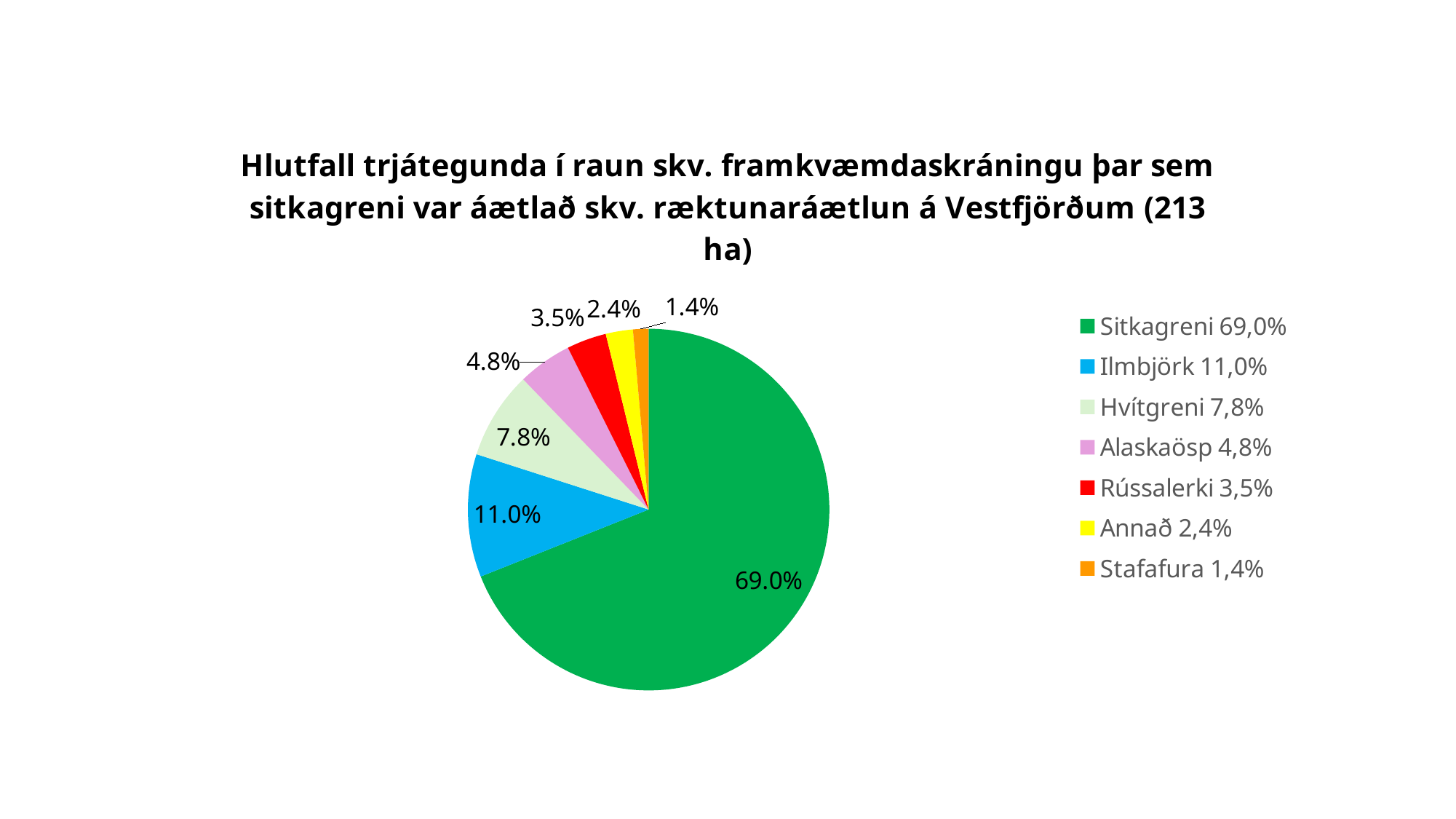
What colour is the slice for Ilmbjörk? blue How many slices does the pie chart have? 7 What is the value shown for Alaskaösp? 4.8% Which is larger, the share for Rússalerki or the share for Annað? Rússalerki What is the difference between the shares of Ilmbjörk and Hvítgreni? 3.2% What is the value shown for Stafafura? 1.4% Which tree species has the largest slice of the pie? Sitkagreni What is the value shown for Ilmbjörk? 11.0% What share of the pie does Sitkagreni have? 69.0% Which tree species has the smallest slice of the pie? Stafafura What kind of chart is shown on the slide? pie chart What is the value shown for Hvítgreni? 7.8%